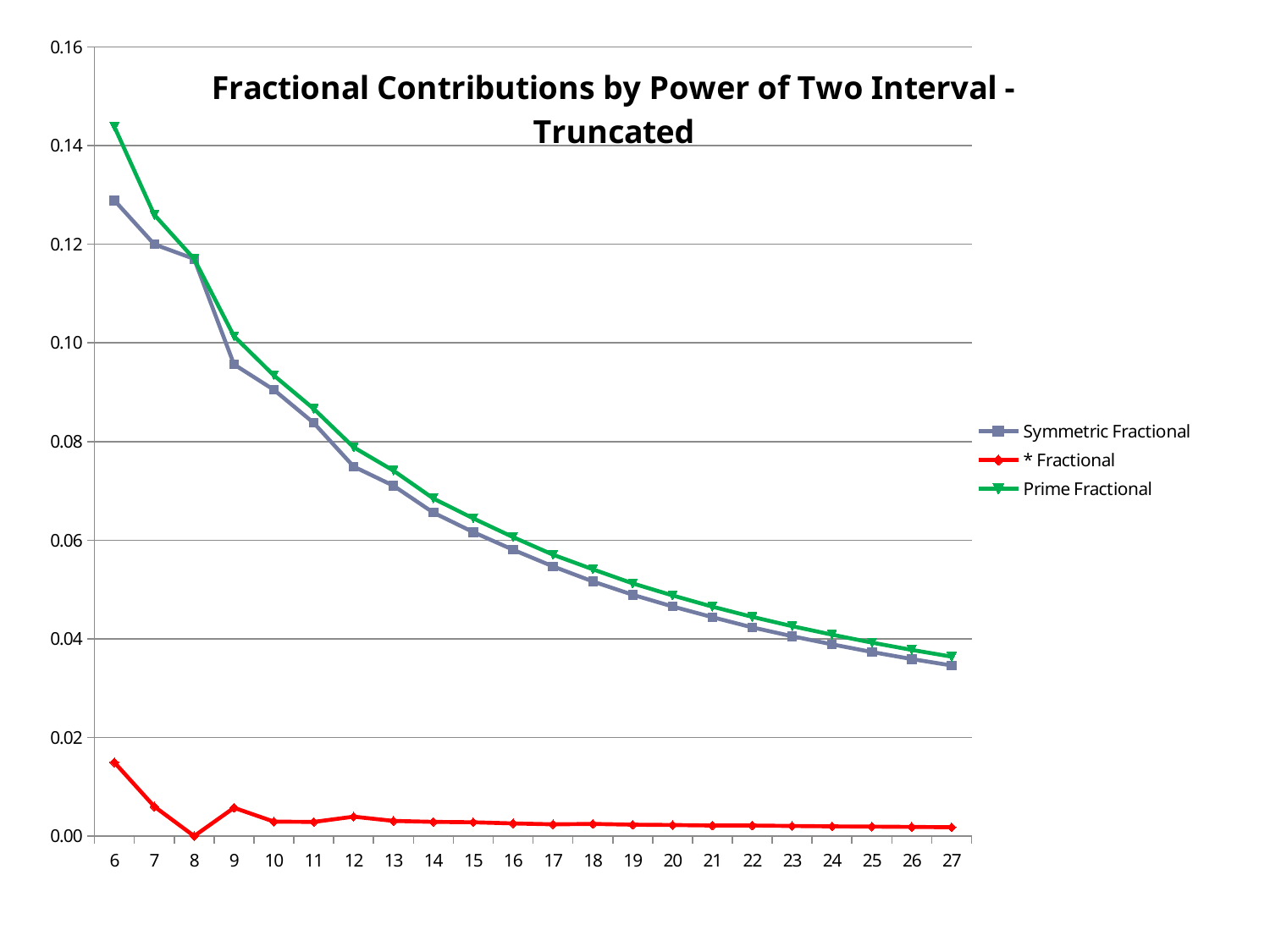
What is the title of the chart? Fractional Contributions by Power of Two Interval - Truncated Which series is drawn in red? * Fractional How many points are plotted along the x axis for each series? 22 Is the value for Symmetric Fractional at x = 6 greater or less than 0.12? greater Which series has the lowest values across the whole chart? * Fractional Does the Prime Fractional series rise or fall as the x axis goes from 6 to 27? fall Is the value for Symmetric Fractional at x = 27 greater or less than 0.04? less Which series has the highest value at x = 6? Prime Fractional At x = 27, which is larger: Prime Fractional or * Fractional? Prime Fractional At which x value does the * Fractional series reach its lowest point? 8 What kind of chart is shown on the slide? line chart How many series does the legend list? 3